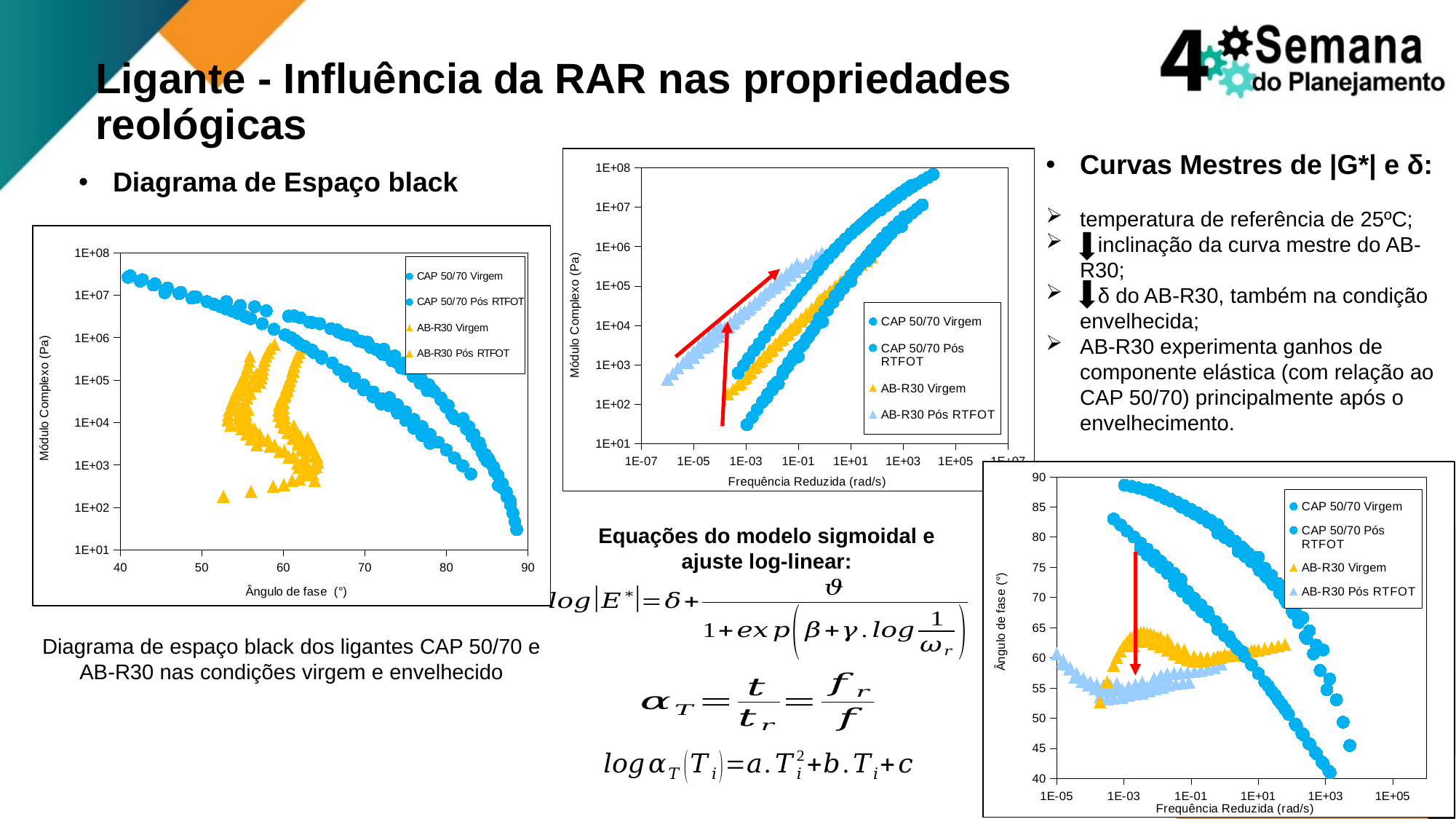
What is the x-axis title of the left-hand Black space diagram? Ângulo de fase (°) In the top-middle master curve chart of Módulo Complexo, do the values rise or fall as the reduced frequency increases? rise In the bottom-right phase angle master curve chart, do the CAP 50/70 values rise or fall as the reduced frequency increases? fall How many series does the legend of the top-middle master curve chart list? 4 How many charts are shown on the slide? 3 What kind of chart is the 'Diagrama de Espaço black' chart on the left of the slide? Scatter chart In the left-hand Black space diagram, is the largest phase angle reached by the AB-R30 Virgem series greater or less than 70? less In the bottom-right phase angle master curve chart, is the highest phase angle of the CAP 50/70 Virgem series greater or less than 85? greater In the left-hand Black space diagram, is the largest phase angle reached by the CAP 50/70 series greater or less than 80? greater How many series does the legend of the left-hand Black space diagram list? 4 What is the x-axis title of the top-middle master curve chart? Frequência Reduzida (rad/s)